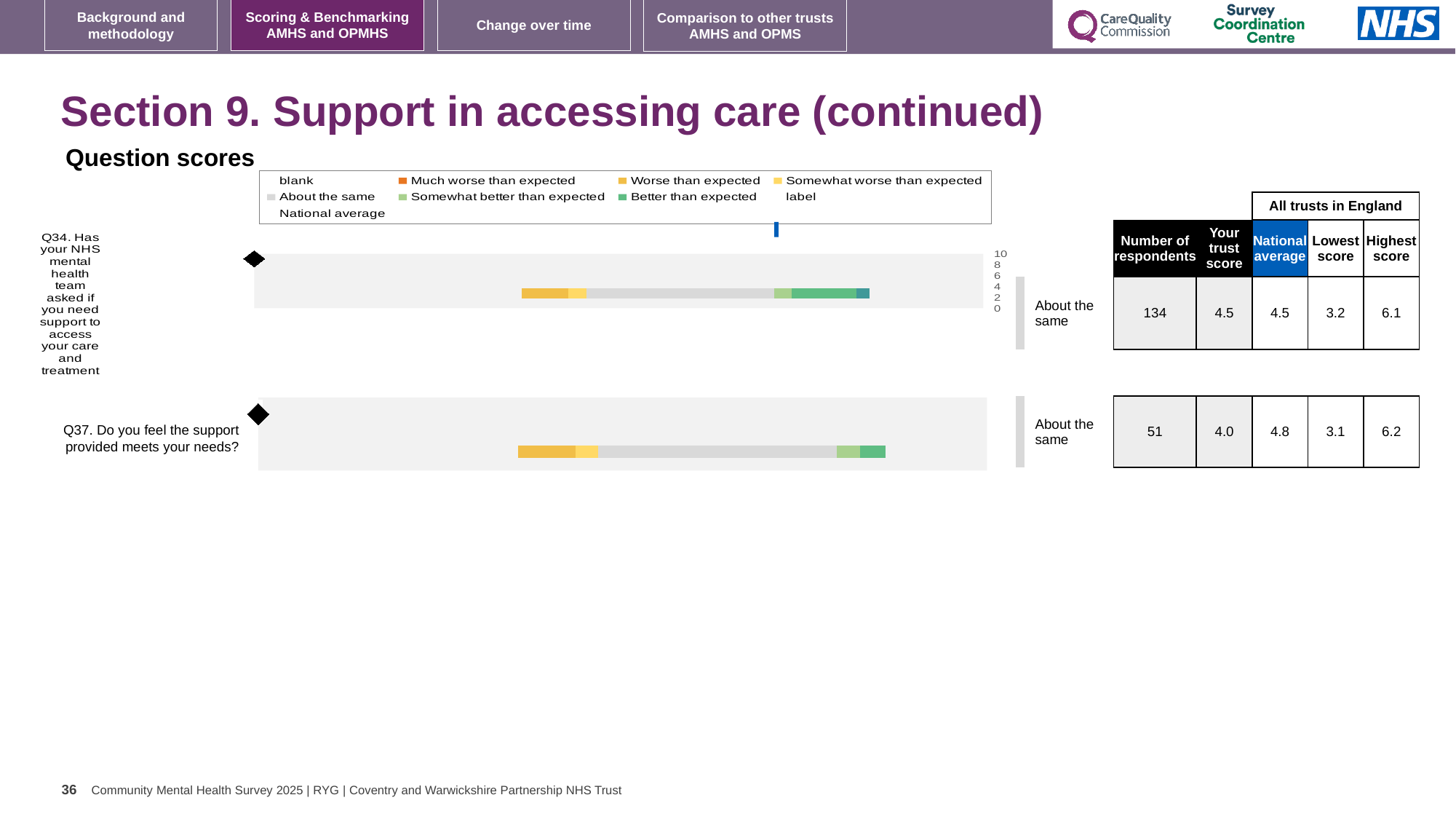
What kind of chart is used to show the question scores for Q34 and Q37? bar chart How many questions are plotted in the question scores chart? 2 How many respondents answered Q34? 134 What benchmark category is shown for Q34 (Has your NHS mental health team asked if you need support to access your care and treatment)? About the same What is the trust score for Q34? 4.5 What is the national average for Q37 (Do you feel the support provided meets your needs)? 4.8 What is the difference between the highest score and the lowest score for Q37? 3.1 What is the lowest score among all trusts in England for Q37? 3.1 For Q37, which is larger: the trust score or the national average? national average What is the highest score among all trusts in England for Q34? 6.1 Which question had more respondents, Q34 or Q37? Q34 Which colour in the legend represents 'Better than expected'? green